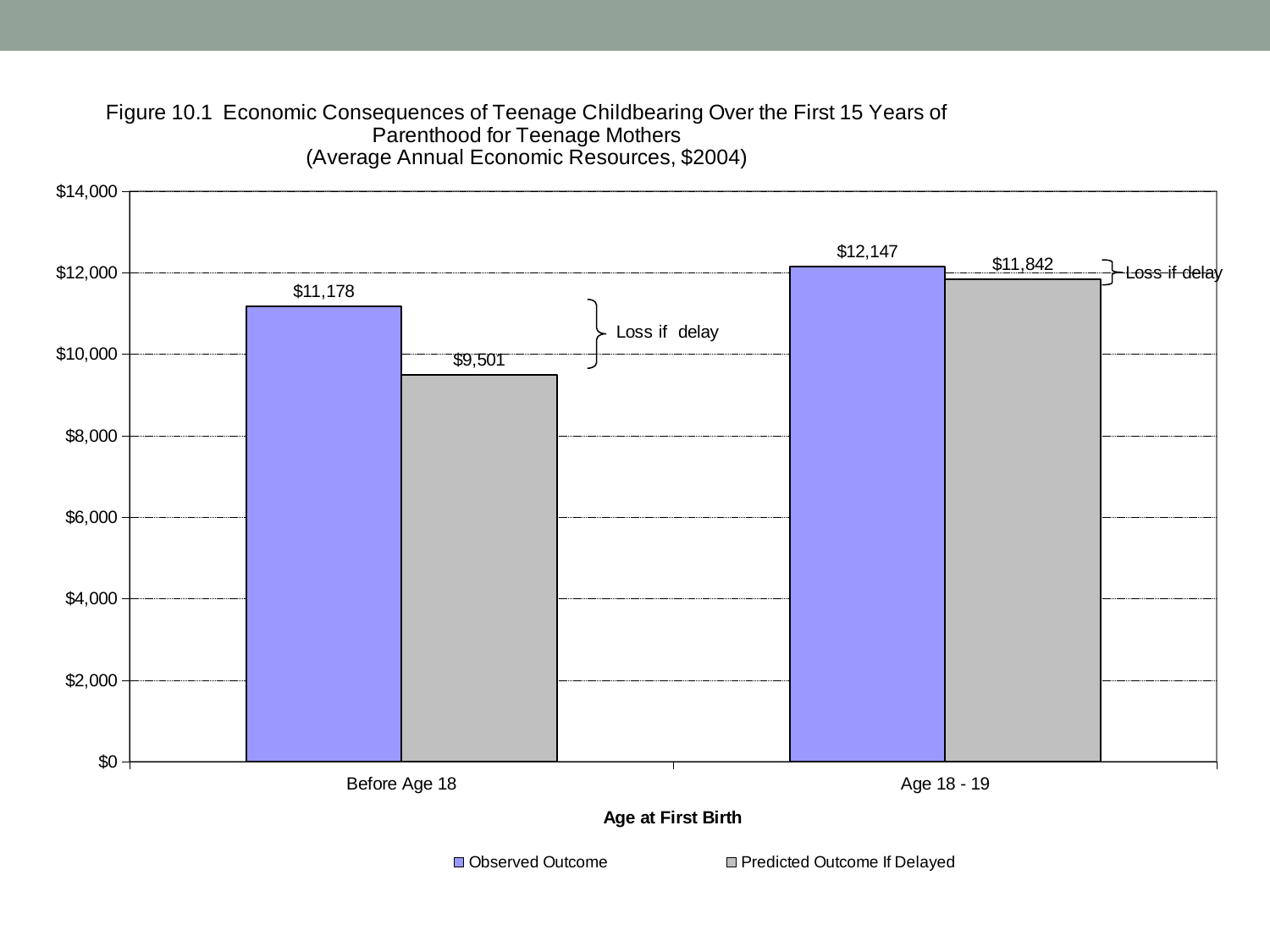
Is the Observed Outcome for Before Age 18 larger or smaller than the Observed Outcome for Age 18 - 19? smaller How many series does the legend list? 2 What is the difference between the Observed Outcome and the Predicted Outcome If Delayed for Before Age 18? $1,677 What is the difference between the Observed Outcome and the Predicted Outcome If Delayed for Age 18 - 19? $305 What is the title of the x axis? Age at First Birth What kind of chart is shown on the slide? bar chart What is the Observed Outcome value for Age 18 - 19? $12,147 What is the Observed Outcome value for Before Age 18? $11,178 Which age group has the highest Observed Outcome? Age 18 - 19 Which bar shows the lowest value on the chart? Predicted Outcome If Delayed for Before Age 18 What is the Predicted Outcome If Delayed value for Before Age 18? $9,501 What is the Predicted Outcome If Delayed value for Age 18 - 19? $11,842